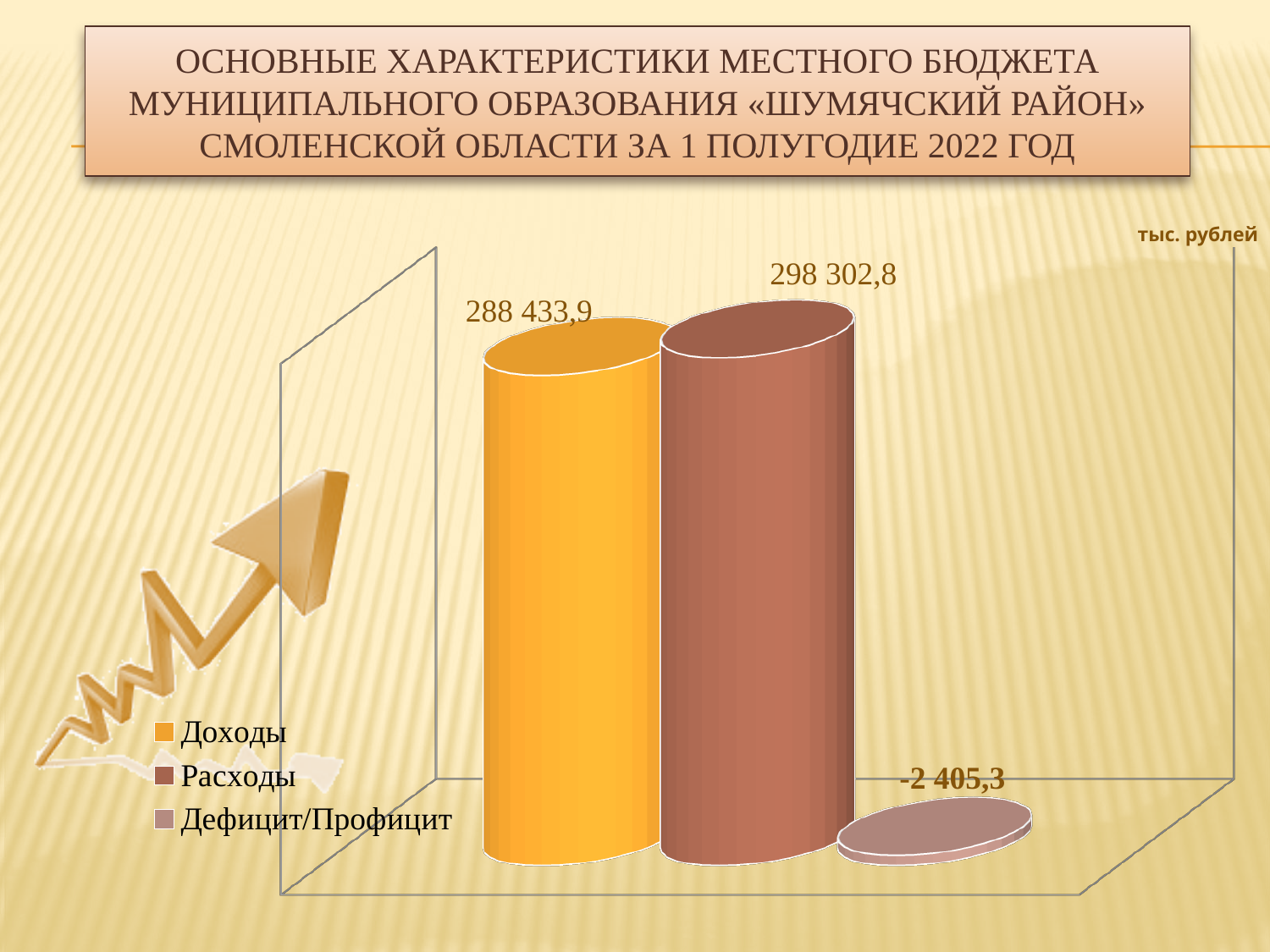
How many bars are plotted on the chart? 3 What is the value shown for Расходы? 298 302,8 How many series does the legend list? 3 What unit of measurement is indicated on the chart? тыс. рублей Which series has the highest value? Расходы What kind of chart is shown on the slide? Bar chart What is the value shown for Дефицит/Профицит? -2 405,3 What is the value shown for Доходы? 288 433,9 What is the difference between Расходы and Доходы? 9 868,9 Which series has the lowest value? Дефицит/Профицит Which legend entry is shown in orange? Доходы Which is larger, Доходы or Расходы? Расходы